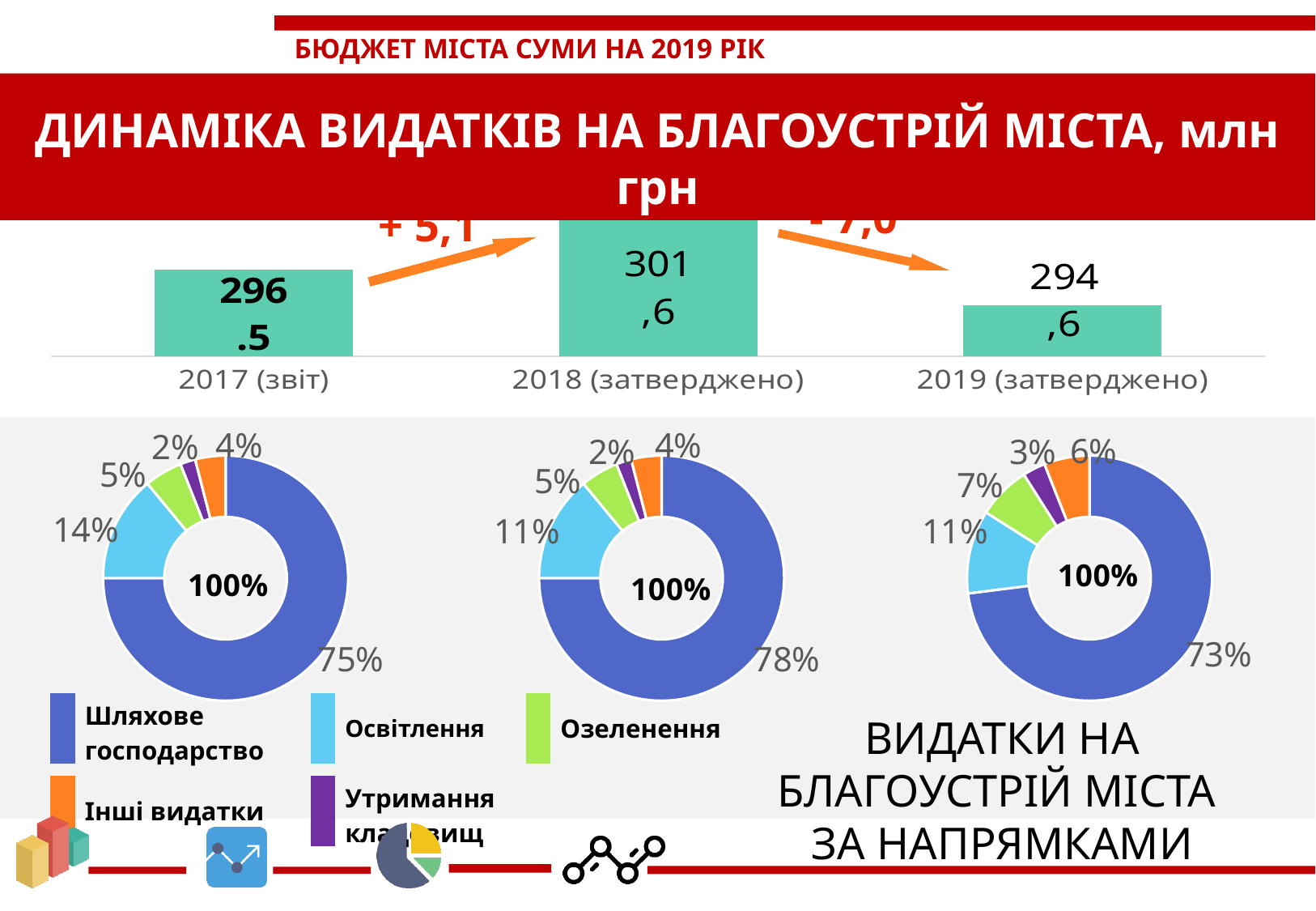
In the bar chart at the top of the slide, what is the value for 2018 (затверджено)? 301,6 In the right donut chart, what share does Озеленення have? 7% In the bar chart at the top of the slide, how many bars are shown? 3 In the bar chart at the top of the slide, which year has the lowest value? 2019 (затверджено) In the bar chart at the top of the slide, what is the value for 2019 (затверджено)? 294,6 In the right donut chart, what share does Інші видатки have? 6% Which is larger: the share of Шляхове господарство in the middle donut chart or in the right donut chart? middle donut chart What kind of chart is shown at the top of the slide? bar chart How many categories does the legend below the donut charts list? 5 In the left donut chart, what share does Шляхове господарство have? 75% In the bar chart at the top of the slide, which year has the highest value? 2018 (затверджено)